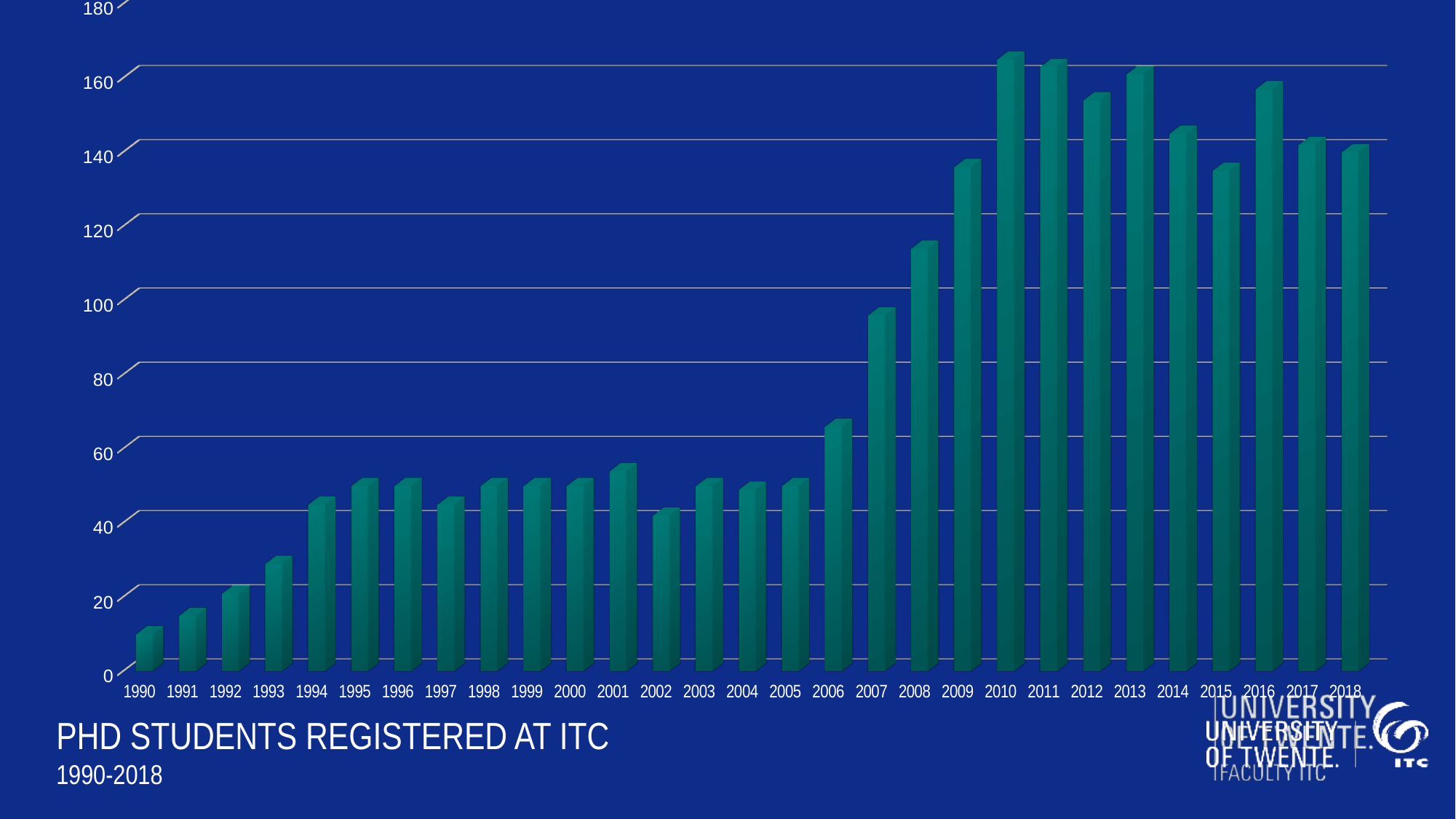
Is the value for 2002 greater or less than 60? less How many years (bars) are plotted on the x axis? 29 Which is larger, the value for 2006 or the value for 2007? 2007 Is the value for 2012 greater or less than 140? greater Do the values rise or fall from 2006 to 2010? rise Which year has the lowest number of PhD students registered? 1990 Is the value for 1993 greater or less than 40? less What is the title of the chart? PHD STUDENTS REGISTERED AT ITC Which is larger, the value for 2001 or the value for 2002? 2001 What kind of chart is shown on the slide? bar chart